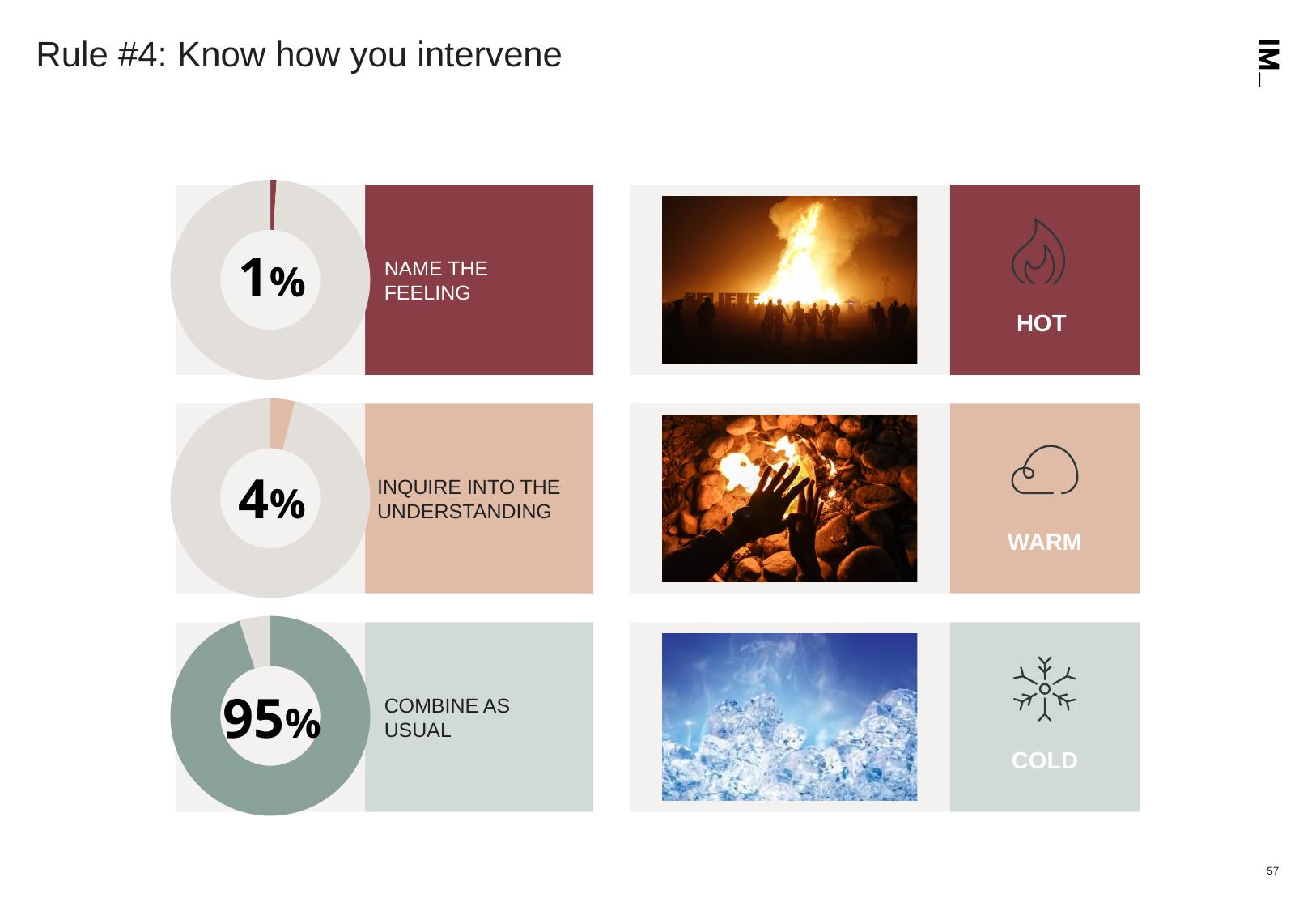
What is the difference between the percentage on the bottom donut chart ("COMBINE AS USUAL") and the percentage on the middle donut chart ("INQUIRE INTO THE UNDERSTANDING")? 91% On the bottom donut chart labelled "COMBINE AS USUAL", what percentage is shown? 95% Across the three donut charts on the left of the slide, which labelled intervention has the lowest percentage? NAME THE FEELING Across the three donut charts on the left of the slide, which labelled intervention has the highest percentage? COMBINE AS USUAL What kind of chart is used on the left side of the slide to show the percentages? Donut chart Which temperature label on the right of the slide is paired with the donut chart showing 95%? COLD What is the difference between the percentage on the middle donut chart ("INQUIRE INTO THE UNDERSTANDING") and the percentage on the top donut chart ("NAME THE FEELING")? 3% Comparing the top and middle donut charts, which is larger: the percentage for "NAME THE FEELING" or for "INQUIRE INTO THE UNDERSTANDING"? INQUIRE INTO THE UNDERSTANDING On the middle donut chart labelled "INQUIRE INTO THE UNDERSTANDING", what percentage is shown? 4% How many donut charts are on the slide? 3 On the top donut chart labelled "NAME THE FEELING", what percentage is shown? 1% What is the total of the percentages shown on the three donut charts on the left of the slide? 100%